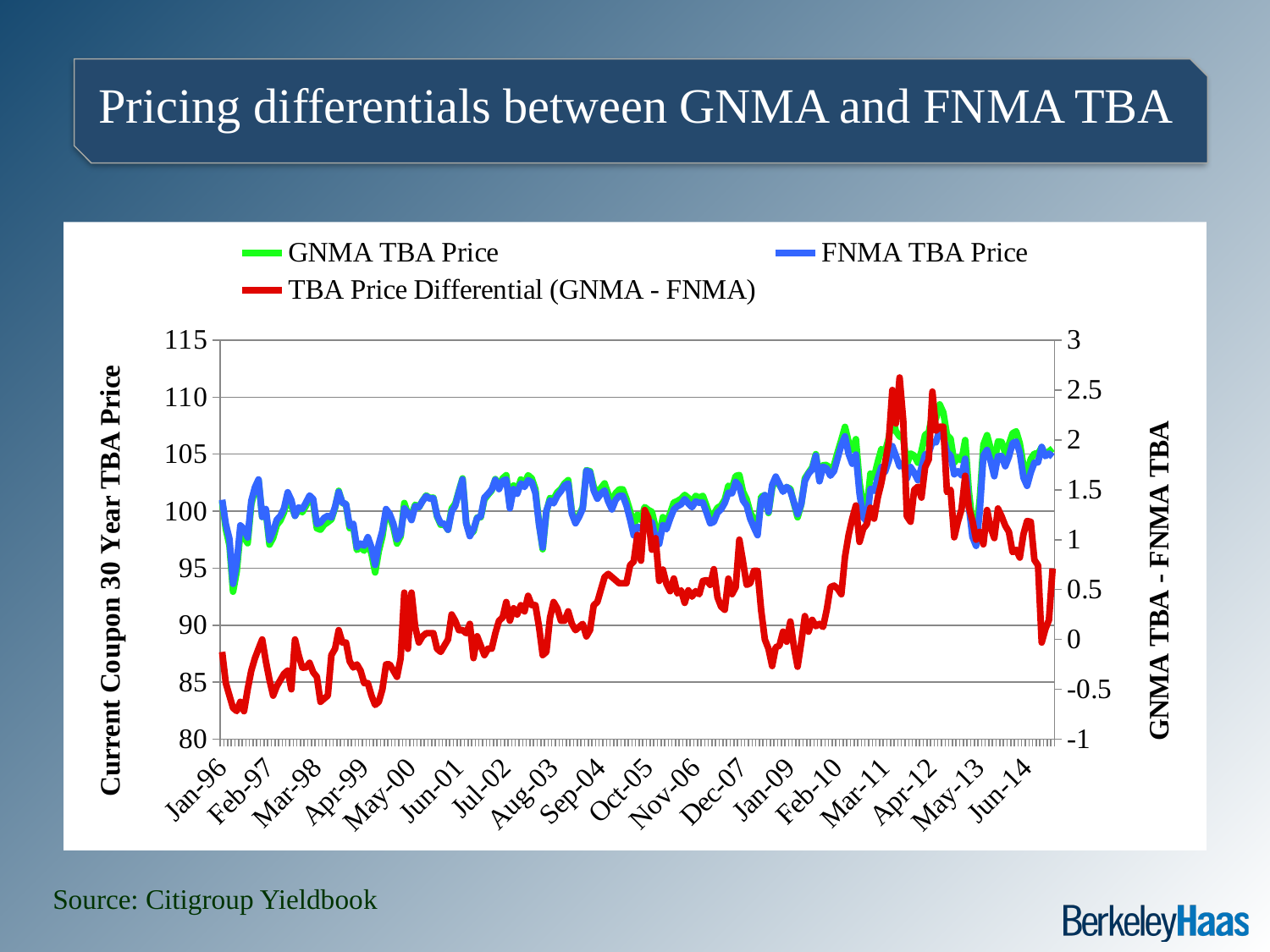
Does the TBA Price Differential (GNMA - FNMA) generally rise or fall from Jan-96 to Mar-11? rise Is the TBA Price Differential (GNMA - FNMA) at its peak around Mar-11 greater or less than 2? greater How many series does the legend list? 3 Is the FNMA TBA Price at the end of the series around Jun-14 greater or less than 100? greater What kind of chart is shown on the slide? line chart Is the GNMA TBA Price around Feb-10 greater or less than 100? greater What is the label of the left vertical axis? Current Coupon 30 Year TBA Price What is the title of the chart on the slide? Pricing differentials between GNMA and FNMA TBA Which is larger around Mar-11: the TBA Price Differential (GNMA - FNMA) or the value 1 on the right axis? TBA Price Differential (GNMA - FNMA)